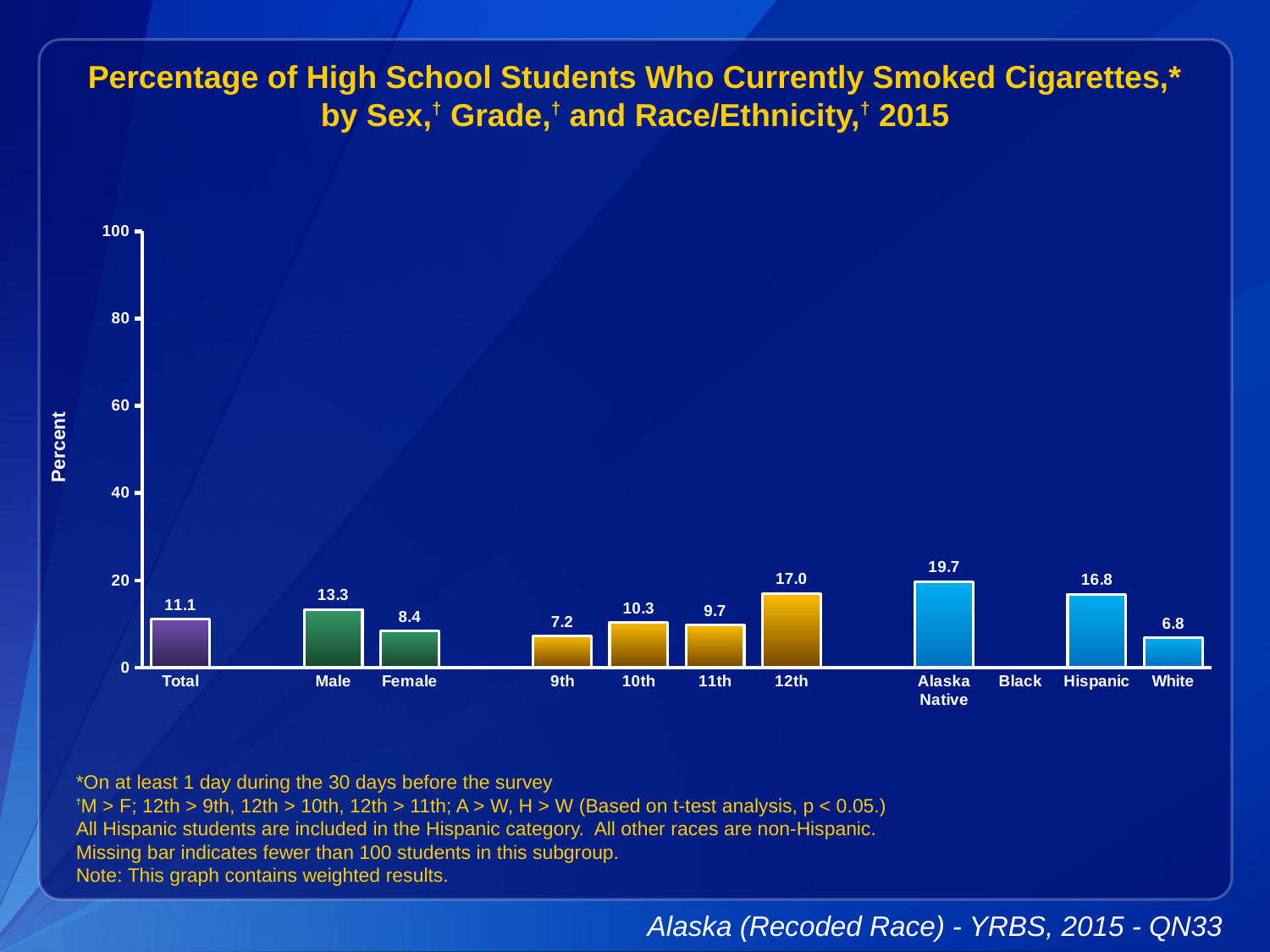
What is the value for 12th grade? 17.0 What kind of chart is this? bar chart What is the value for Alaska Native? 19.7 Is the value for 12th grade greater or less than 20? less How many categories have a bar plotted? 10 Which is larger, the value for Hispanic or the value for White? Hispanic What is the value for Male? 13.3 What is the difference between the Male and Female values? 4.9 Which category has the highest value? Alaska Native Which category has the lowest value among those with a bar shown? White What is the value for Total? 11.1